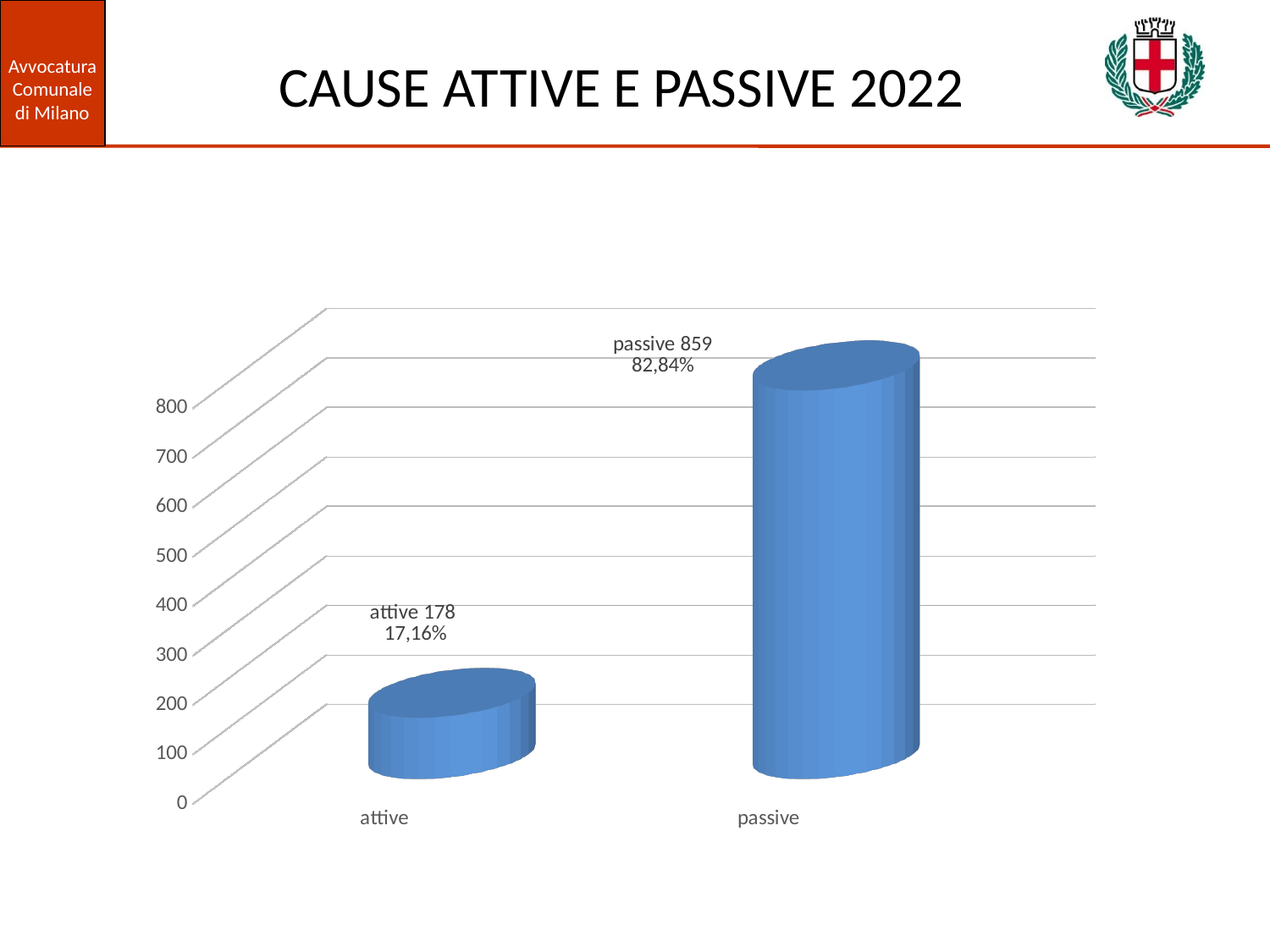
What percentage is shown for passive? 82,84% How many categories are shown in the chart? 2 Which is larger, the value for attive or the value for passive? passive What kind of chart is shown on the slide? bar chart What is the title of the slide? CAUSE ATTIVE E PASSIVE 2022 Which category has the highest value? passive What is the value for attive? 178 What percentage is shown for attive? 17,16% What is the value for passive? 859 What is the difference between the values for passive and attive? 681 Is the value for attive greater or less than 200? less Which category has the lowest value? attive